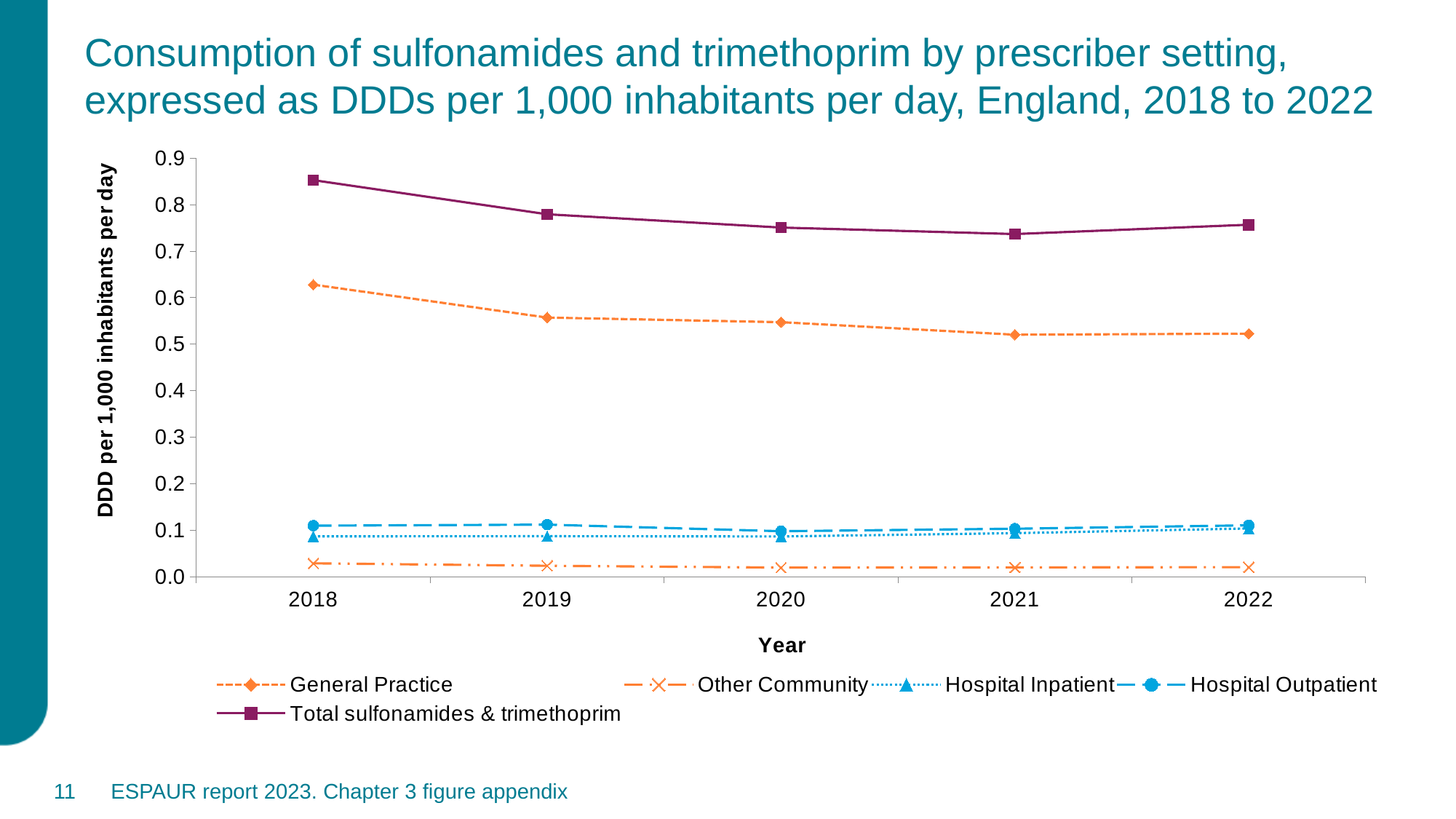
Is the value for General Practice in 2022 greater or less than 0.6? less Is the value for Other Community in 2020 greater or less than 0.1? less Which is larger, the General Practice value in 2018 or in 2019? 2018 Which series has the lowest values across all years? Other Community Does the General Practice series rise or fall from 2018 to 2021? fall How many years are plotted along the x axis? 5 Is the value for Total sulfonamides & trimethoprim in 2018 greater or less than 0.8? greater In which year is the value for Total sulfonamides & trimethoprim highest? 2018 What kind of chart is shown on the slide? line chart How many series does the legend list? 5 Which is larger in 2018, Hospital Outpatient or Hospital Inpatient? Hospital Outpatient